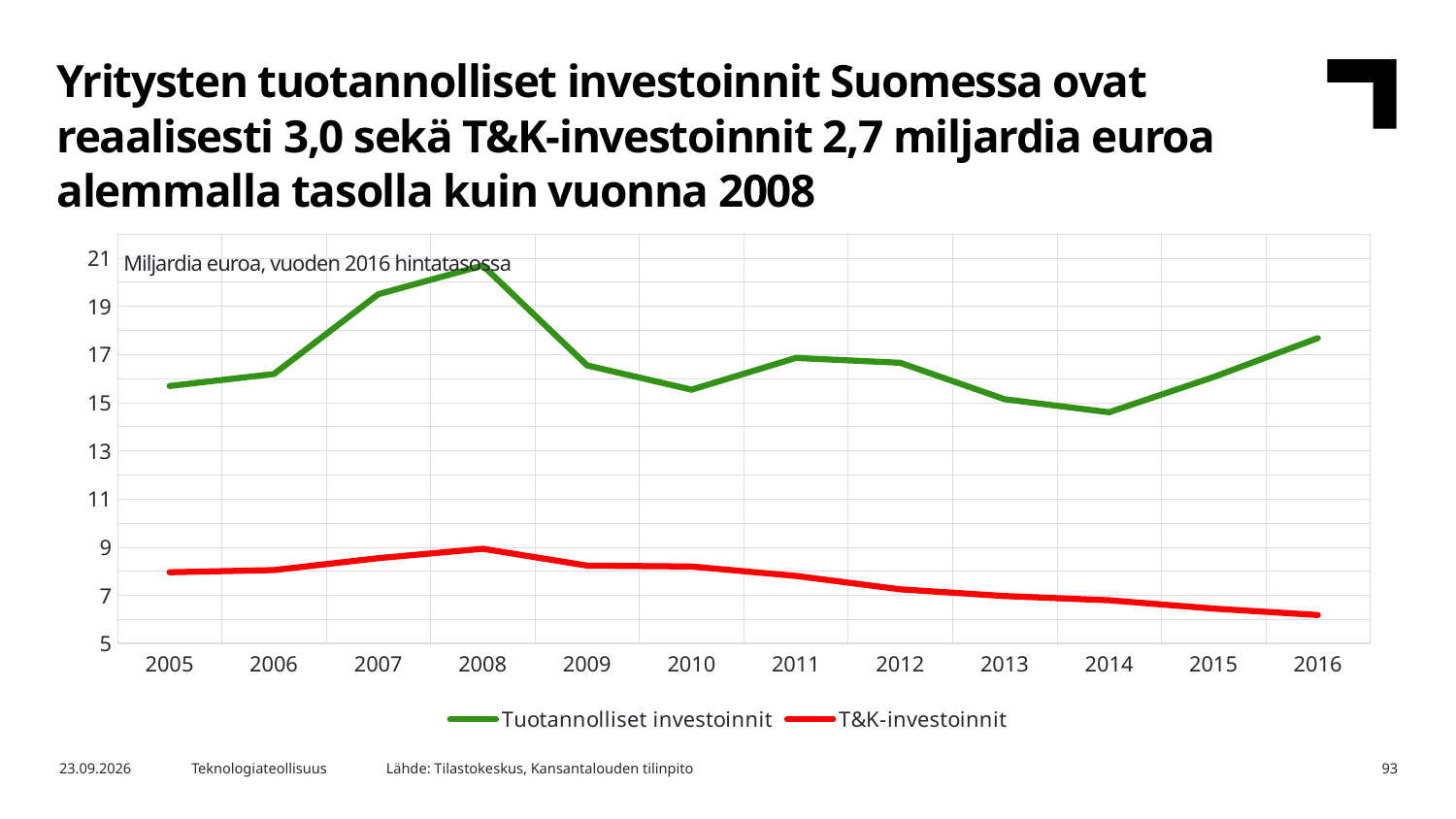
How many series does the legend list? 2 How many years are shown on the x axis? 12 Which series has the larger value in 2008, Tuotannolliset investoinnit or T&K-investoinnit? Tuotannolliset investoinnit In which year is T&K-investoinnit at its highest? 2008 What kind of chart is shown on the slide? Line chart Is the value for Tuotannolliset investoinnit in 2014 greater or less than 15? less In which year is T&K-investoinnit at its lowest? 2016 In which year is Tuotannolliset investoinnit at its highest? 2008 Does T&K-investoinnit rise or fall from 2008 to 2016? Fall Is the value for T&K-investoinnit in 2016 greater or less than 7? less Is the value for Tuotannolliset investoinnit in 2008 greater or less than 19? greater In which year is Tuotannolliset investoinnit at its lowest? 2014